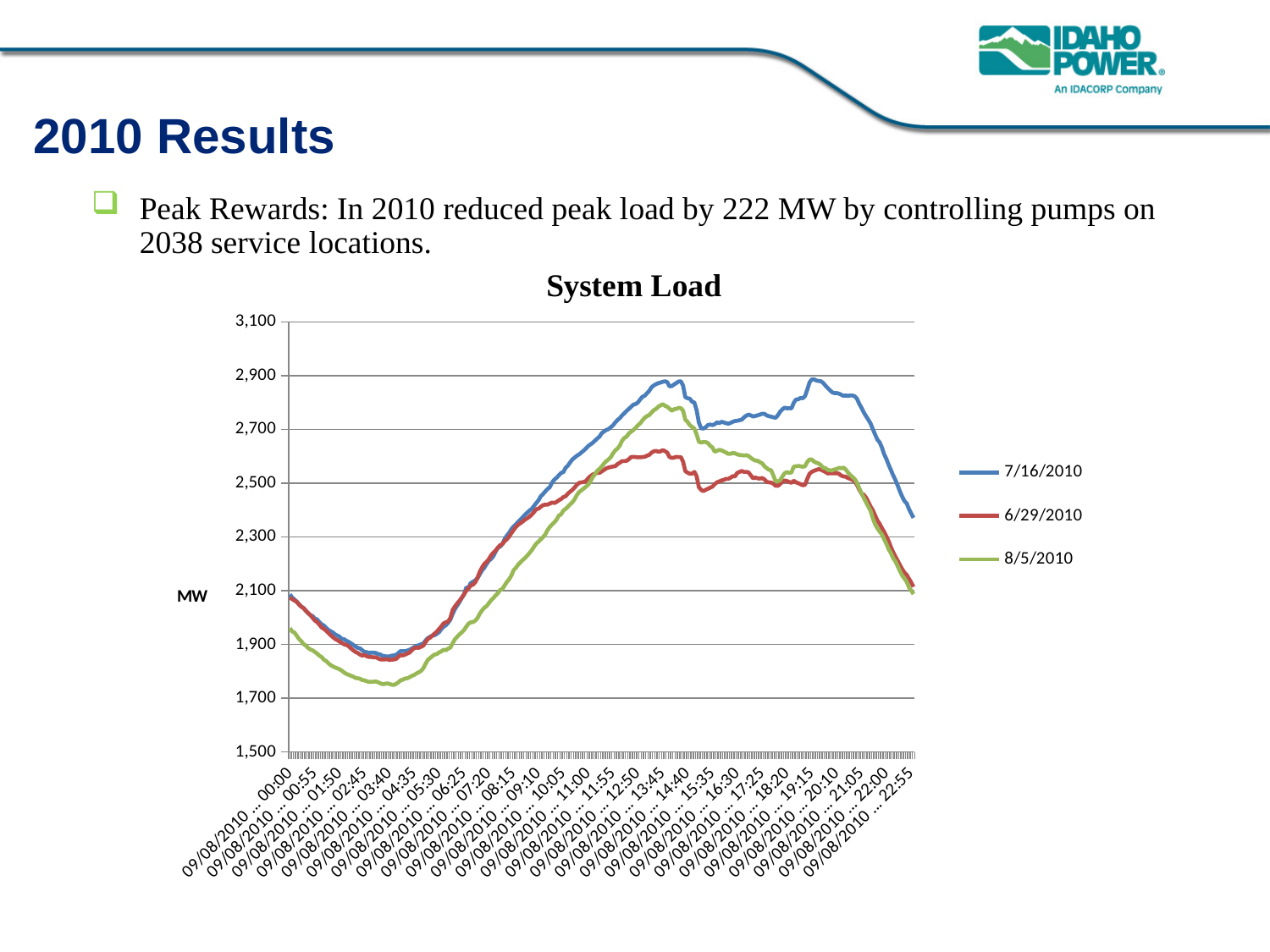
How many series does the legend of the System Load chart list? 3 Which series reaches the highest system load on the chart? 7/16/2010 Is the lowest value of the 8/5/2010 line greater or less than 1,900? less At 13:45, which series has the higher load, 7/16/2010 or 6/29/2010? 7/16/2010 Is the peak value of the 6/29/2010 line greater or less than 2,700? less Is the peak value of the 7/16/2010 line greater or less than 2,700? greater What is the title of the chart on the slide? System Load Between 03:40 and 13:45, does the 7/16/2010 line rise or fall? rise What are the three series listed in the legend of the System Load chart? 7/16/2010, 6/29/2010, 8/5/2010 Between 20:10 and 22:55, do the lines rise or fall? fall Which series has the lowest system load around 03:40? 8/5/2010 What kind of chart is shown on the slide? line chart